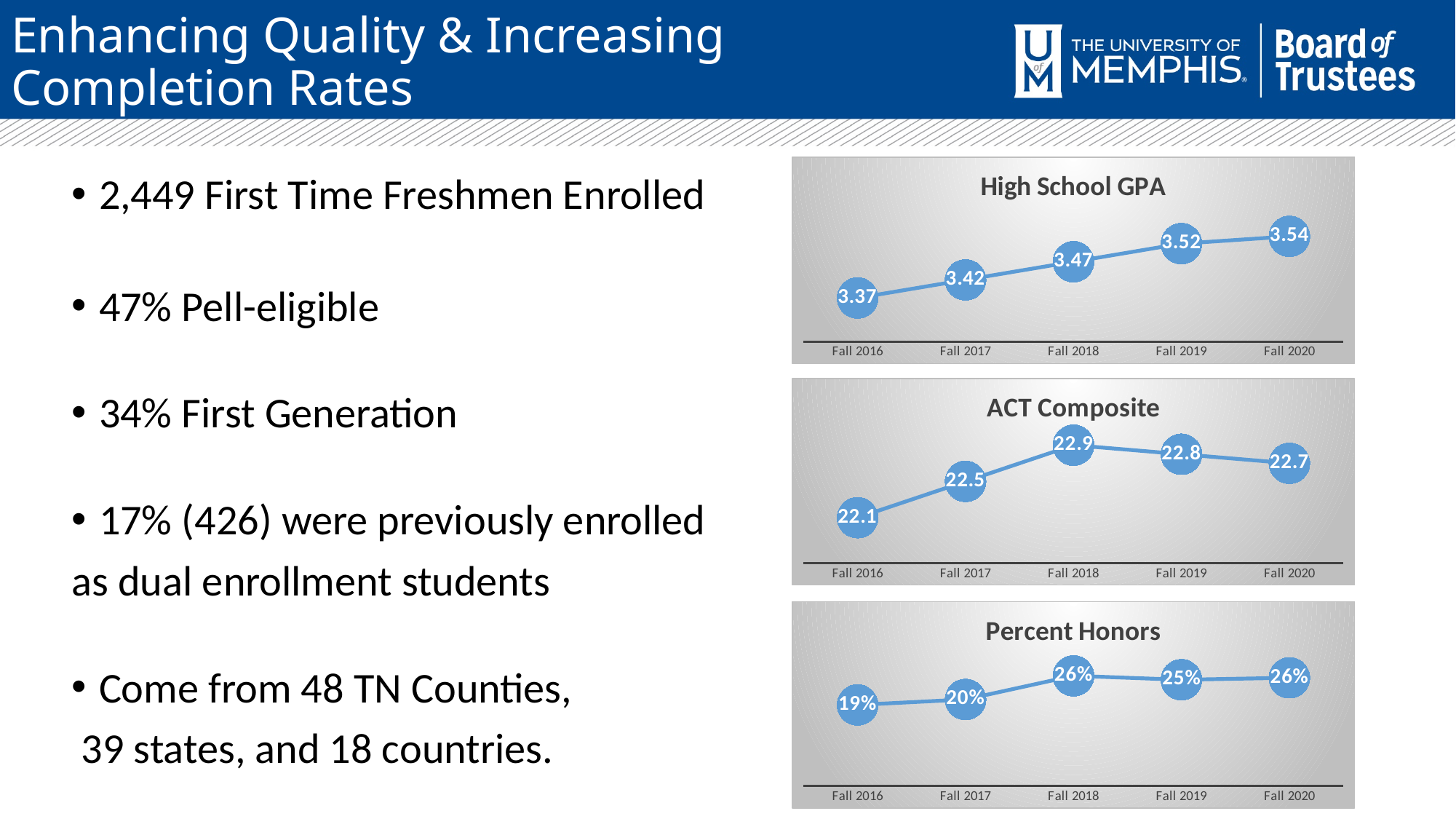
In the Percent Honors chart, what is the value for Fall 2019? 25% In the High School GPA chart, do the values rise or fall from Fall 2016 to Fall 2020? rise In the Percent Honors chart, what is the difference between the Fall 2018 and Fall 2016 values? 7% In the ACT Composite chart, which term has the lowest value? Fall 2016 In the ACT Composite chart, which is larger, the value for Fall 2019 or Fall 2020? Fall 2019 In the ACT Composite chart, which term has the highest value? Fall 2018 In the High School GPA chart, what is the difference between the Fall 2020 and Fall 2016 values? 0.17 What kind of chart is the ACT Composite chart? line chart In the High School GPA chart, what is the value for Fall 2018? 3.47 In the High School GPA chart, which term has the highest value? Fall 2020 In the ACT Composite chart, what is the value for Fall 2017? 22.5 How many data points are plotted in the Percent Honors chart? 5